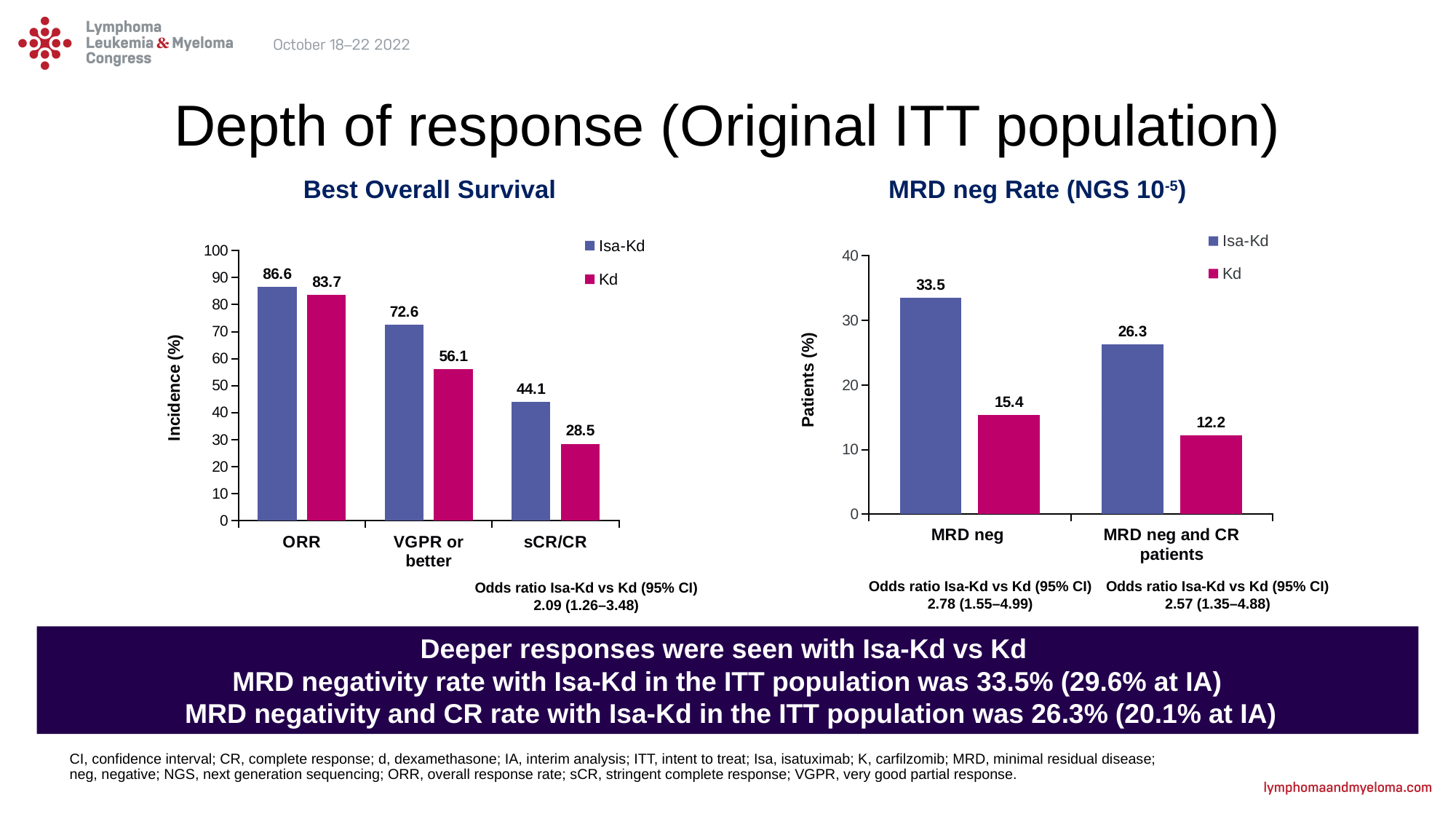
What type of chart is the Best Overall Survival chart? bar chart How many series does the legend of the MRD neg Rate chart list? 2 In the MRD neg Rate chart, what is the difference between Isa-Kd and Kd at MRD neg? 18.1 In the MRD neg Rate chart, what is the value for Kd at MRD neg? 15.4 In the Best Overall Survival chart, what is the value for Isa-Kd at ORR? 86.6 In the Best Overall Survival chart, what is the difference between Isa-Kd and Kd at VGPR or better? 16.5 In the Best Overall Survival chart, what is the value for Kd at sCR/CR? 28.5 In the MRD neg Rate chart, what is the value for Isa-Kd at MRD neg and CR patients? 26.3 In the Best Overall Survival chart, which category has the lowest Kd value? sCR/CR In the Best Overall Survival chart, do the Isa-Kd values rise or fall from ORR to sCR/CR? fall In the MRD neg Rate chart, which is larger: Kd at MRD neg or Kd at MRD neg and CR patients? Kd at MRD neg In the Best Overall Survival chart, how many categories are shown on the x axis? 3